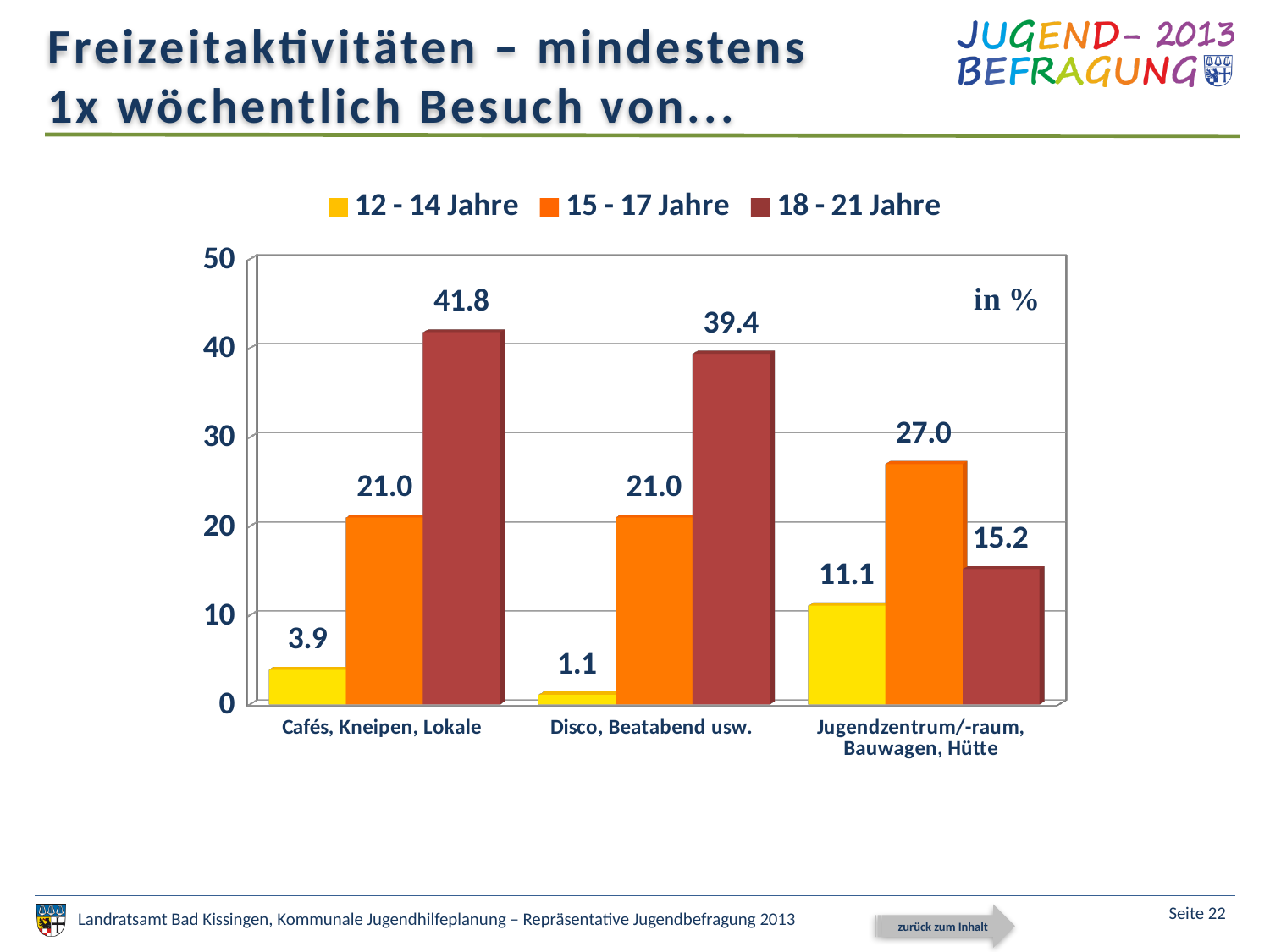
Is the value for 18 - 21 Jahre in the Disco, Beatabend usw. category greater or less than 30? greater What is the value for the 18 - 21 Jahre series in the Cafés, Kneipen, Lokale category? 41.8 How many categories are shown on the x axis? 3 What is the value for the 12 - 14 Jahre series in the Disco, Beatabend usw. category? 1.1 Which category has the lowest value for the 18 - 21 Jahre series? Jugendzentrum/-raum, Bauwagen, Hütte Which category has the highest value for the 12 - 14 Jahre series? Jugendzentrum/-raum, Bauwagen, Hütte What unit is indicated in the chart area? in % What kind of chart is shown on the slide? bar chart What is the value for the 15 - 17 Jahre series in the Jugendzentrum/-raum, Bauwagen, Hütte category? 27.0 In the Jugendzentrum/-raum, Bauwagen, Hütte category, which series has the larger value: 15 - 17 Jahre or 18 - 21 Jahre? 15 - 17 Jahre What is the difference between the 18 - 21 Jahre and 15 - 17 Jahre values in the Cafés, Kneipen, Lokale category? 20.8 How many series does the legend list? 3